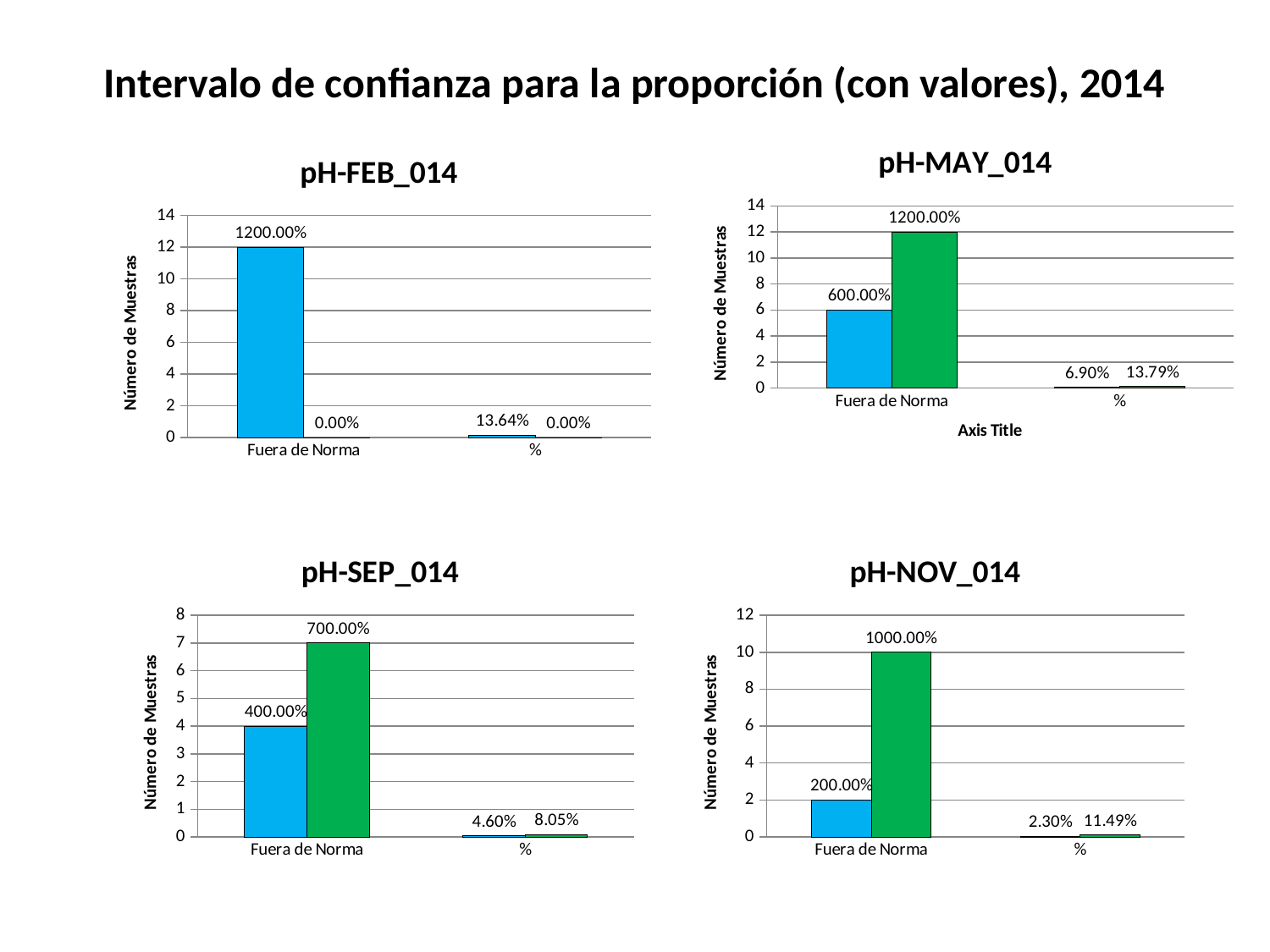
What is the x-axis title shown on the pH-MAY_014 chart? Axis Title How many categories are shown on the x axis of the pH-FEB_014 chart? 2 In the pH-SEP_014 chart, what value is labelled on the blue bar for the % category? 4.60% In the pH-NOV_014 chart, what value is labelled on the blue bar for Fuera de Norma? 200.00% In the pH-SEP_014 chart, what value is labelled on the green bar for Fuera de Norma? 700.00% In the pH-NOV_014 chart, what value is labelled on the green bar for the % category? 11.49% In the pH-MAY_014 chart, what value is labelled on the green bar for Fuera de Norma? 1200.00% In the pH-MAY_014 chart, what value is labelled on the blue bar for Fuera de Norma? 600.00% In the pH-FEB_014 chart, what value is labelled on the tall bar for Fuera de Norma? 1200.00% What kind of chart is pH-FEB_014? bar chart In the pH-NOV_014 chart, which bar for Fuera de Norma is larger, the blue one or the green one? the green one In the pH-SEP_014 chart, what is the difference between the green and blue bar values for Fuera de Norma? 300.00%